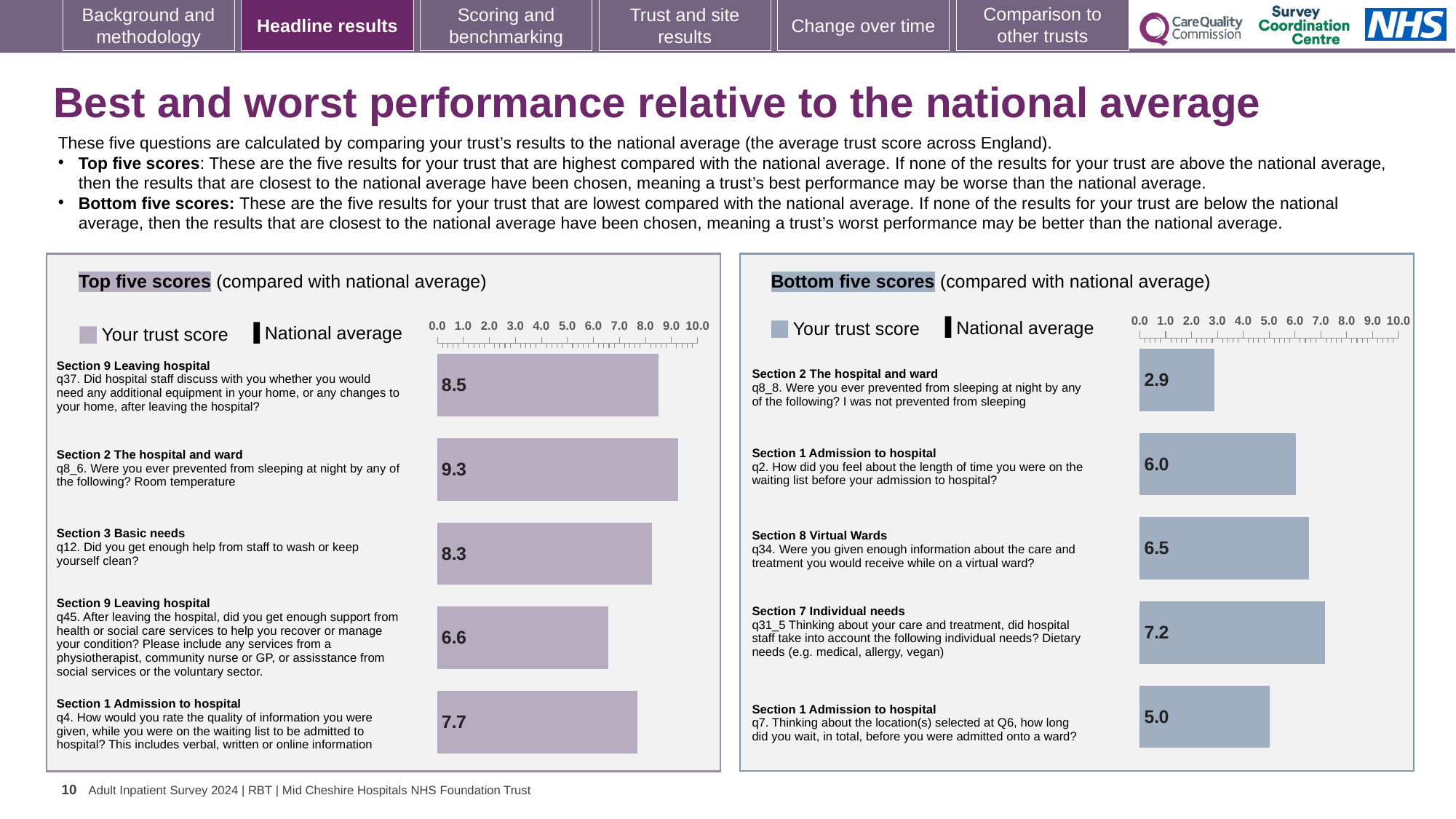
In the Bottom five scores chart, which question has the lowest trust score? q8_8 (I was not prevented from sleeping) In the Bottom five scores chart, what is the difference between the trust scores for q34 and q7? 1.5 In the Bottom five scores chart, what is the trust score for q31_5 (dietary needs)? 7.2 In the Top five scores chart, which question has the highest trust score? q8_6 (Room temperature) What type of chart is used in the Bottom five scores panel? Bar chart How many bars are shown in the Top five scores chart? 5 In the Bottom five scores chart, which has the larger trust score: q2 (waiting list length) or q7 (wait before admitted onto a ward)? q2 (waiting list length) In the Bottom five scores chart, what is the trust score for q8_8 (I was not prevented from sleeping)? 2.9 In the Top five scores chart, what is the trust score for q45 (support from health or social care services after leaving hospital)? 6.6 In the Top five scores chart, what is the trust score for q8_6 (prevented from sleeping at night: room temperature)? 9.3 What is the maximum value shown on the axis of the Top five scores chart? 10.0 In the Top five scores chart, what is the difference between the trust scores for q37 and q4? 0.8